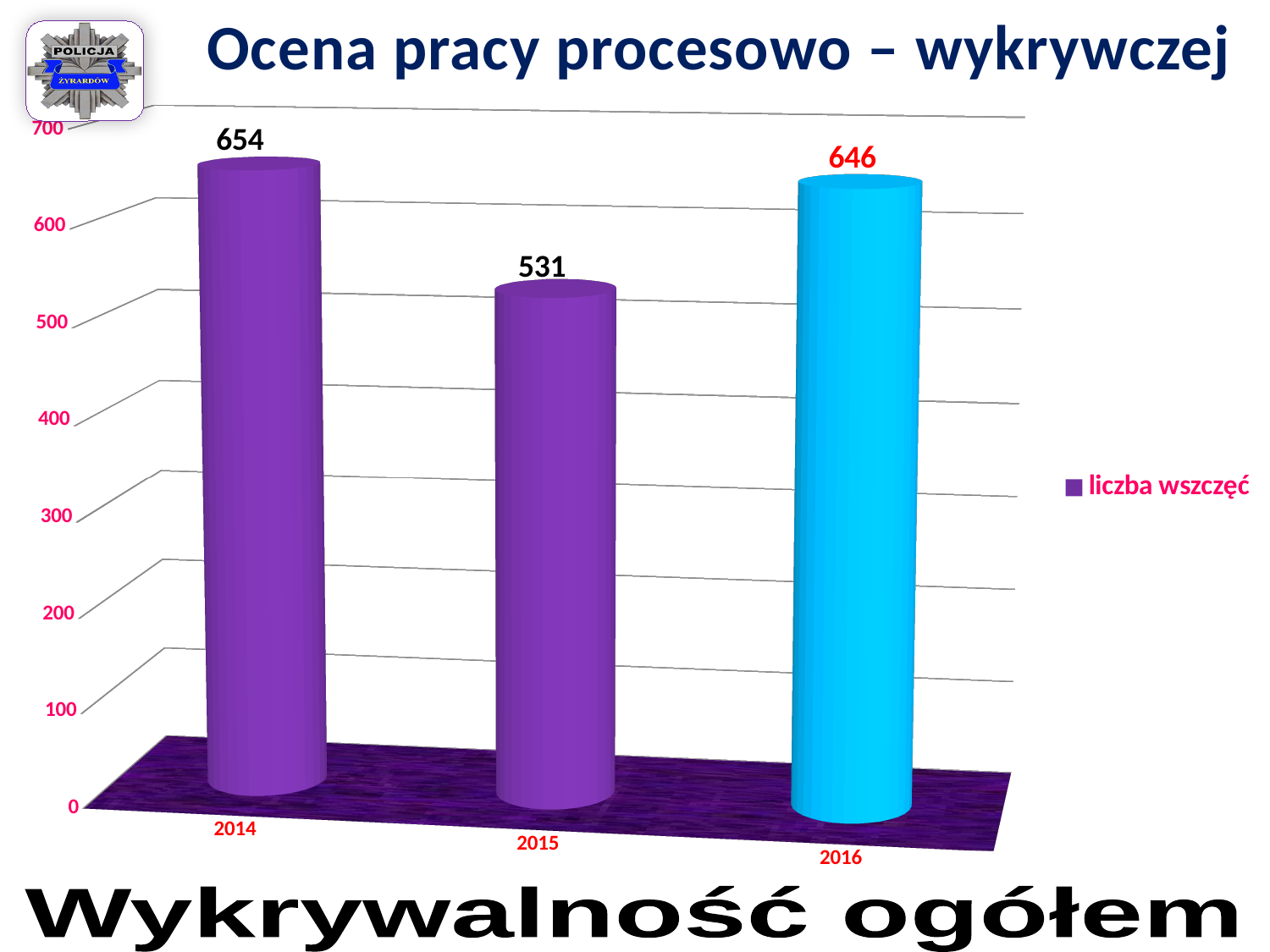
What is the value for 2015? 531 Which year has the highest value? 2014 What is the difference between the values for 2016 and 2015? 115 Is the value for 2015 greater or less than 600? less Which is larger, the value for 2015 or the value for 2016? 2016 What is the value for 2016? 646 What is the value for 2014? 654 What is the difference between the values for 2014 and 2015? 123 Which year has the lowest value? 2015 What series name does the legend show? liczba wszczęć What kind of chart is shown on the slide? bar chart How many years are shown on the x axis? 3